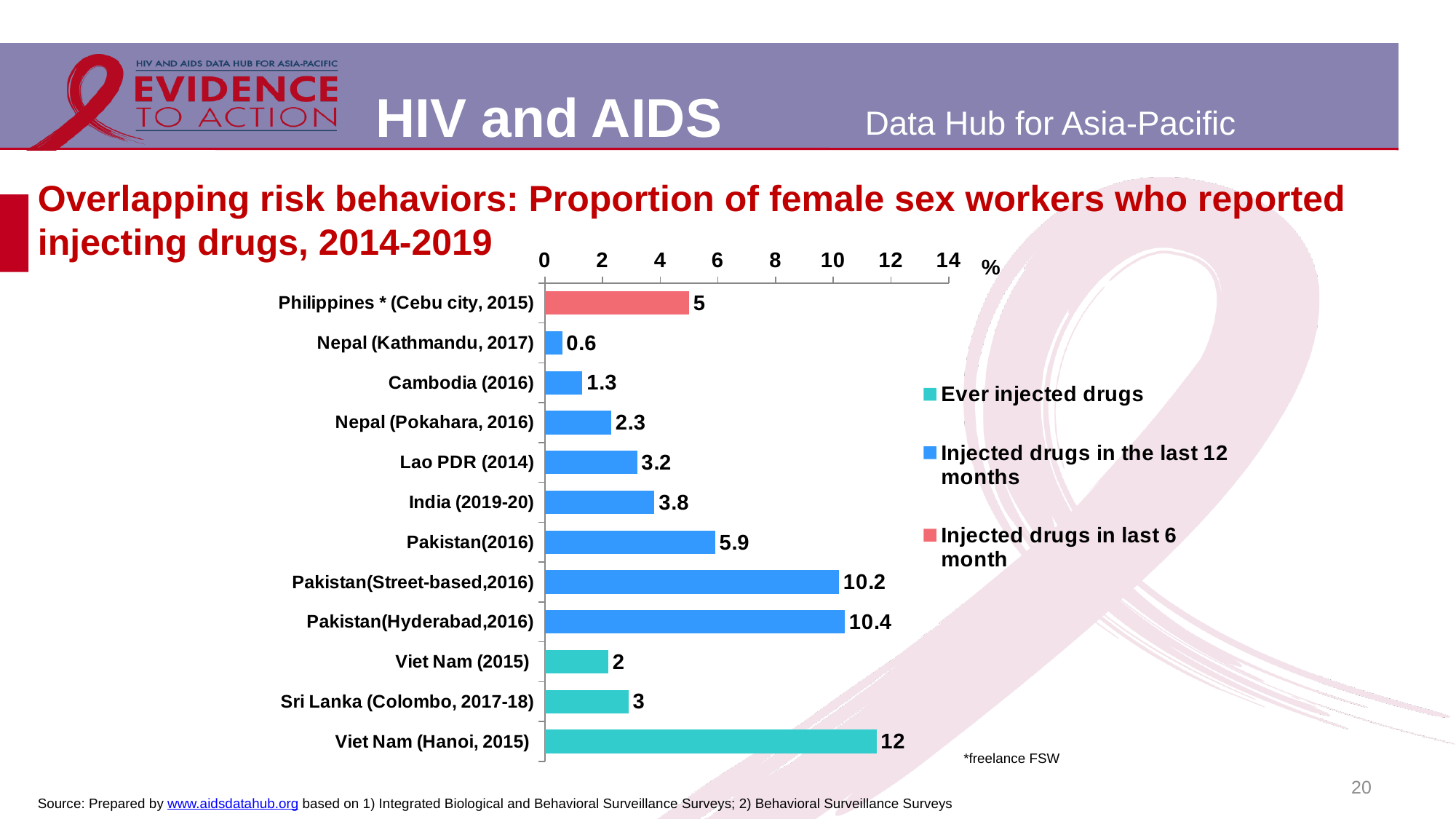
What is the value for Pakistan(Hyderabad,2016)? 10.4 What is the value for Viet Nam (Hanoi, 2015)? 12 Which series does the bar for Philippines * (Cebu city, 2015) belong to? Injected drugs in last 6 month Which category has the lowest value? Nepal (Kathmandu, 2017) How many categories are shown in the chart? 12 How many series does the legend list? 3 Which category has the highest value? Viet Nam (Hanoi, 2015) Which is larger, the value for Lao PDR (2014) or the value for India (2019-20)? India (2019-20) What kind of chart is shown on the slide? Bar chart What is the difference between the values for Pakistan(Hyderabad,2016) and Pakistan(Street-based,2016)? 0.2 What is the value for Nepal (Kathmandu, 2017)? 0.6 What is the value for Philippines * (Cebu city, 2015)? 5